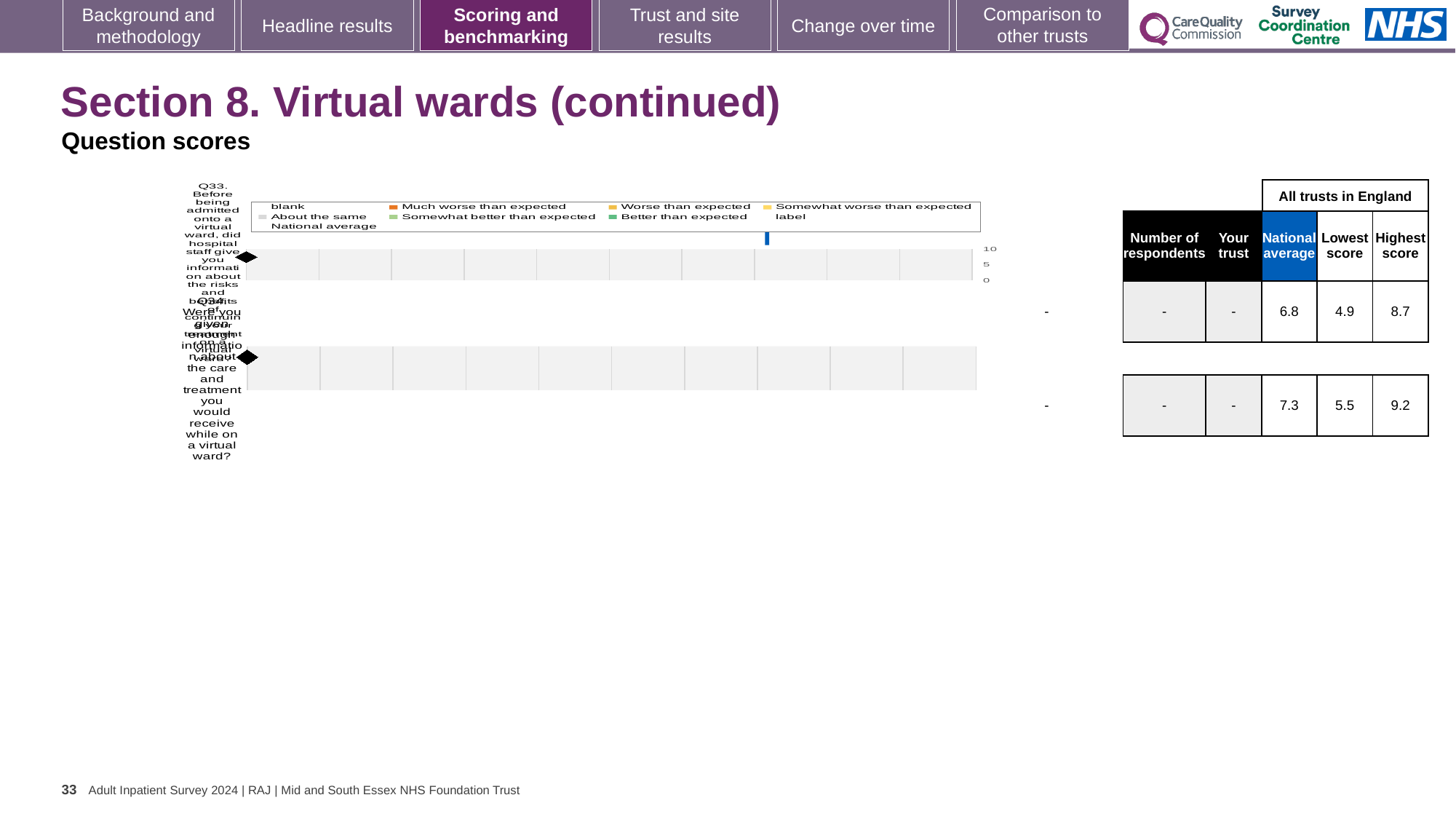
What is the maximum value shown on the chart's score axis? 10 What value is shown for 'Your trust' for Q33? - What is the national average score for Q33 (information about the risks and benefits of continuing treatment on a virtual ward)? 6.8 What is the difference between the highest and lowest scores for Q33? 3.8 What is the national average score for Q34 (enough information about the care and treatment on a virtual ward)? 7.3 Which question has the higher national average, Q33 or Q34? Q34 What is the highest score among all trusts in England for Q34? 9.2 What is the difference between the highest and lowest scores for Q34? 3.7 What is the difference between the national averages of Q34 and Q33? 0.5 What is the lowest score among all trusts in England for Q33? 4.9 What kind of chart is shown on the slide? bar chart How many questions (categories) are plotted on the chart? 2